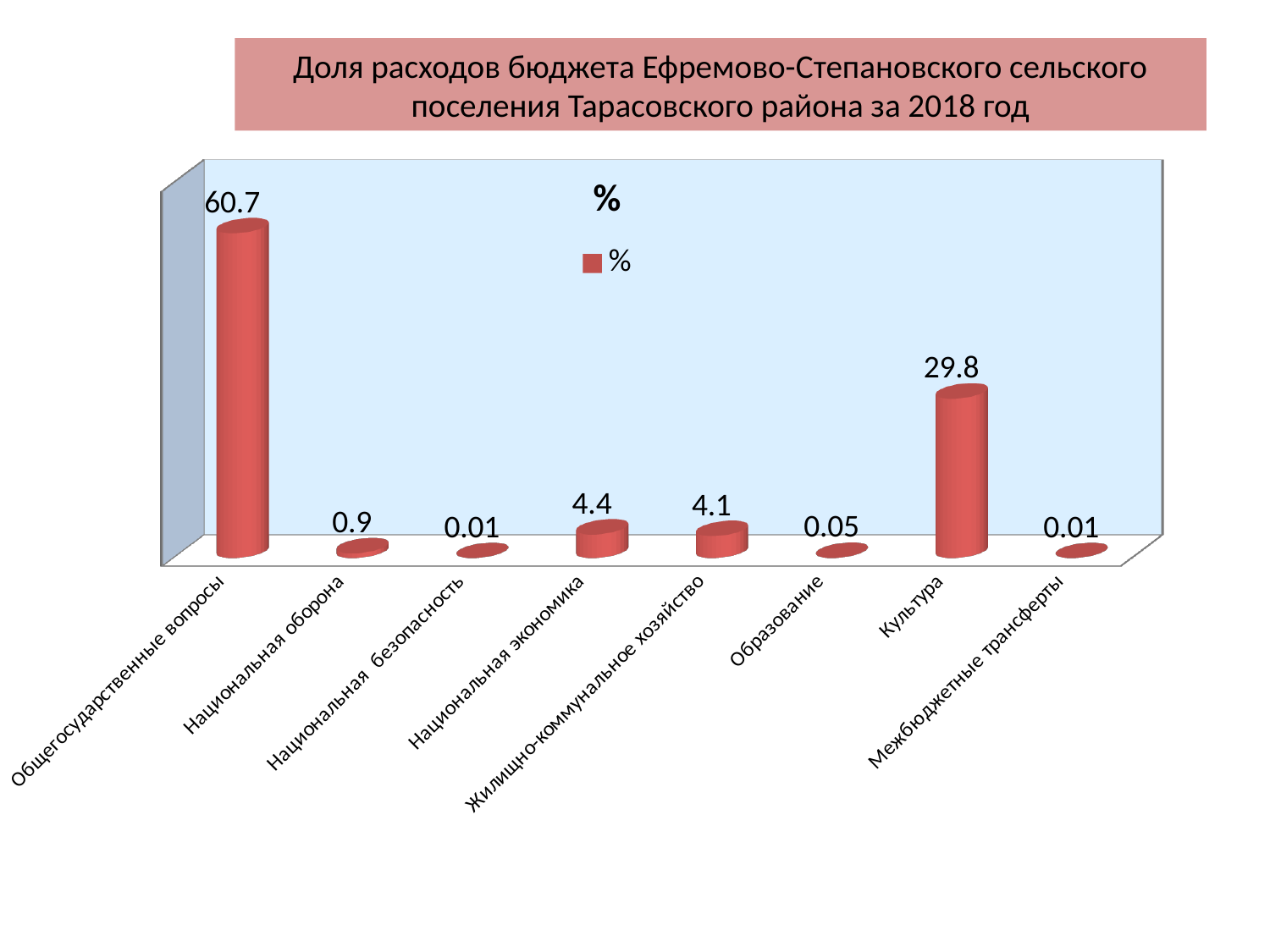
What is the value for Культура? 29.8 Which is larger, the value for Культура or the value for Национальная экономика? Культура What is the difference between the values for Общегосударственные вопросы and Культура? 30.9 What is the difference between the values for Национальная экономика and Жилищно-коммунальное хозяйство? 0.3 What is the value for Национальная оборона? 0.9 What kind of chart is shown on the slide? bar chart How many categories are shown on the x axis? 8 What is the value for Образование? 0.05 What is the value for Национальная экономика? 4.4 What is the value for Общегосударственные вопросы? 60.7 How many series does the legend list? 1 Which category has the highest value? Общегосударственные вопросы